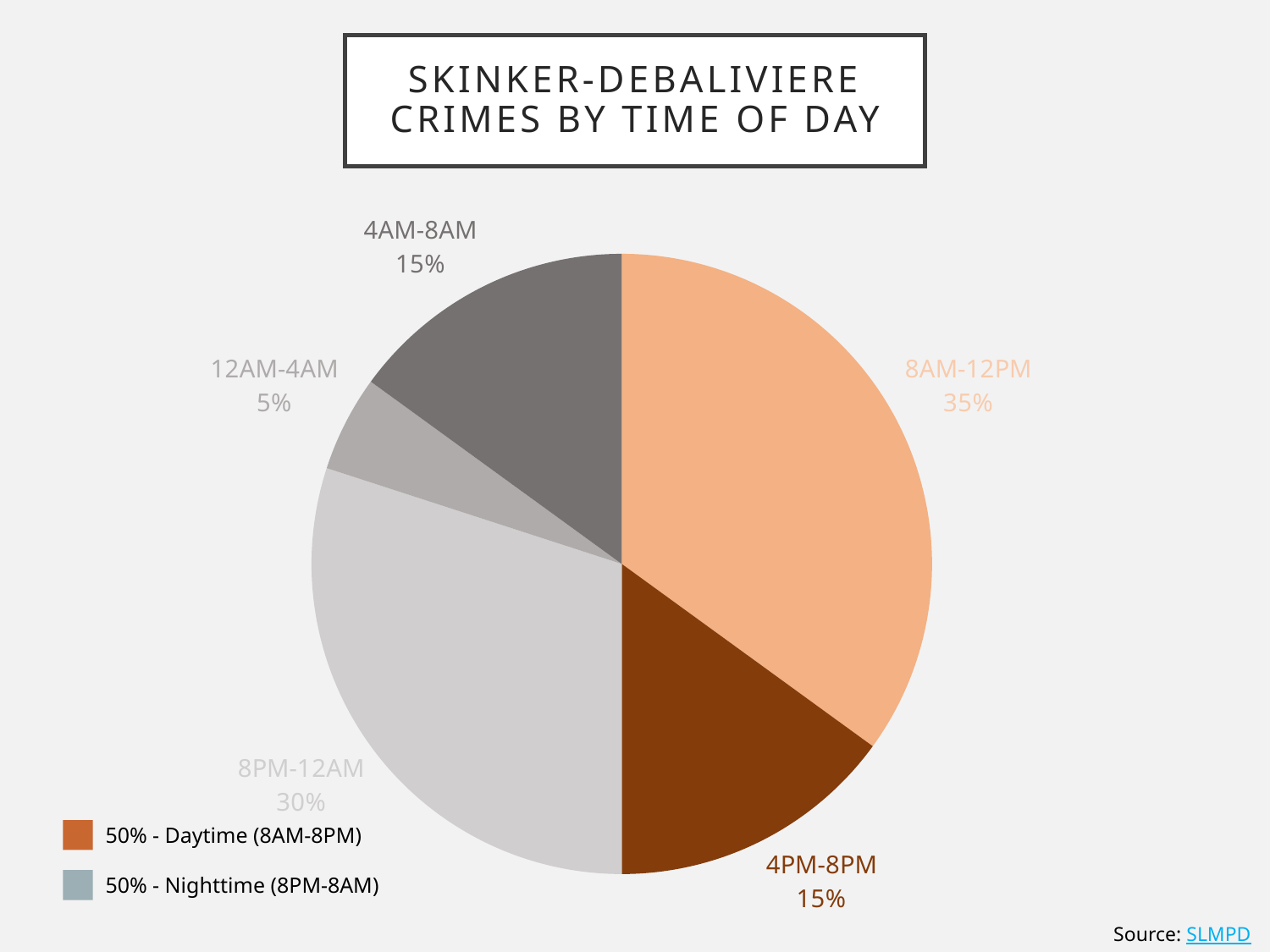
What kind of chart is shown on the slide? pie chart What share of crimes occurred between 8AM and 12PM? 35% What is the title of the chart? Skinker-DeBaliviere Crimes by Time of Day What share of crimes occurred between 12AM and 4AM? 5% Which slice is larger, 8PM-12AM or 4AM-8AM? 8PM-12AM What share of crimes occurred between 8PM and 12AM? 30% What is the difference in percentage points between the 8AM-12PM slice and the 8PM-12AM slice? 5 How many time-of-day slices does the pie chart have? 5 According to the legend, what share of crimes occurred during daytime (8AM-8PM)? 50% Which time period has the largest share of crimes? 8AM-12PM Which time period has the smallest share of crimes? 12AM-4AM